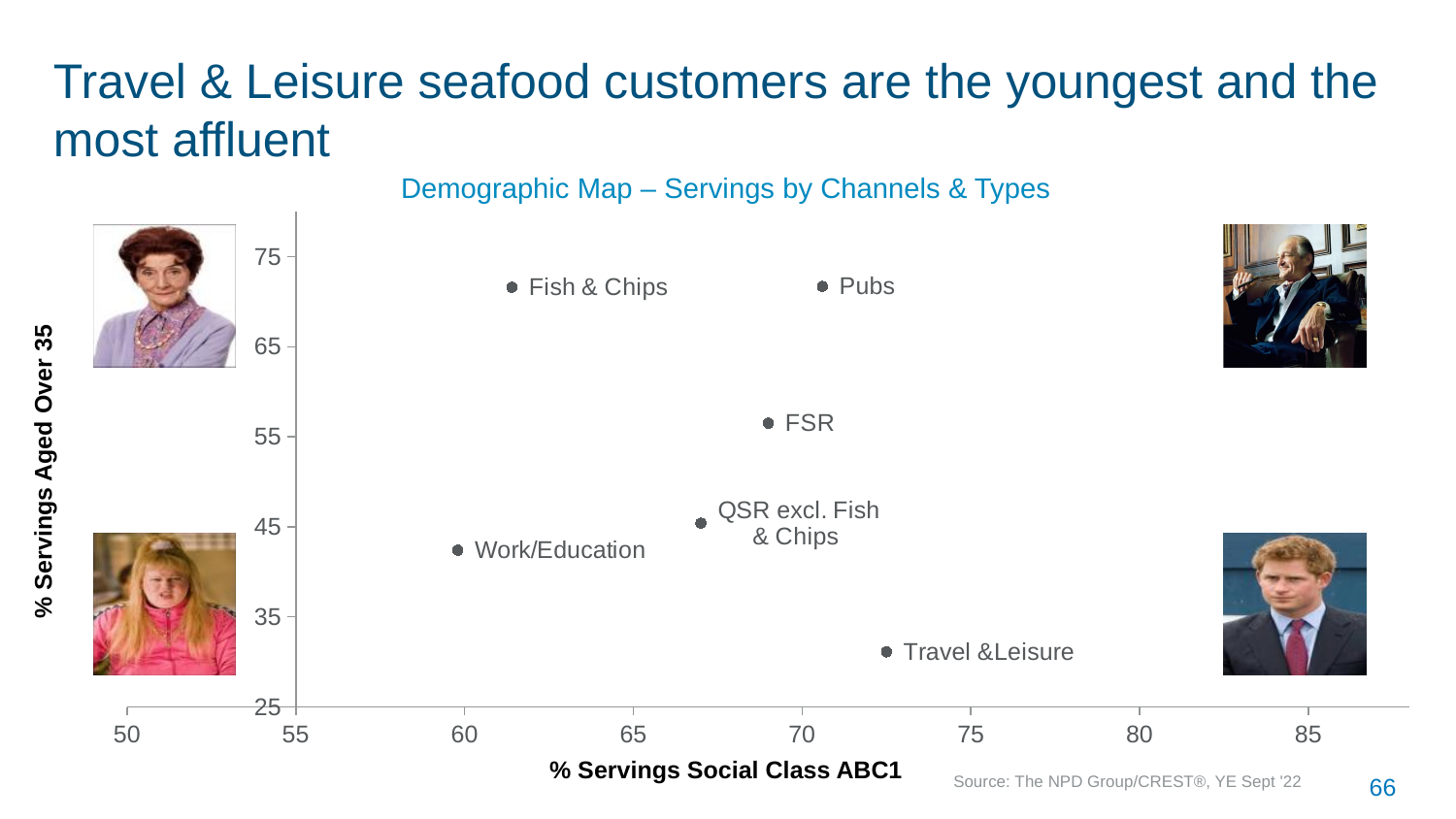
What kind of chart is shown on the slide? Scatter chart Which has a higher % Servings Social Class ABC1, Work/Education or Travel & Leisure? Travel & Leisure Which point has the lowest value for % Servings Social Class ABC1? Work/Education What is the label of the x axis? % Servings Social Class ABC1 How many data points are plotted on the chart? 6 Which point has the lowest value for % Servings Aged Over 35? Travel & Leisure Which has a higher % Servings Aged Over 35, FSR or QSR excl. Fish & Chips? FSR What is the title of the chart? Demographic Map – Servings by Channels & Types Is the % Servings Social Class ABC1 value for Work/Education greater or less than 55? greater Is the % Servings Aged Over 35 value for Travel & Leisure greater or less than 35? less Is the % Servings Aged Over 35 value for Fish & Chips greater or less than 65? greater